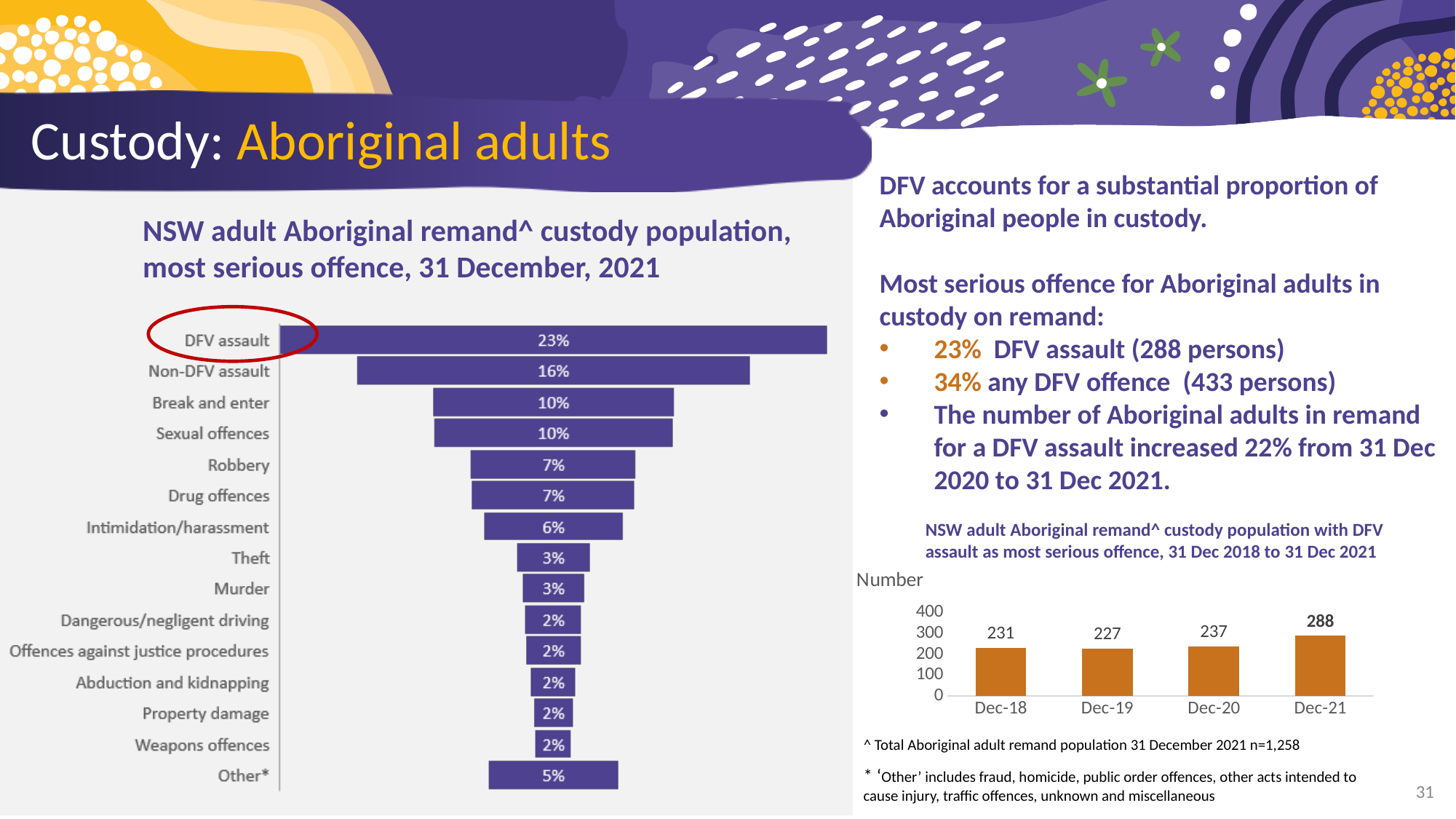
How many bars are shown in the chart titled 'NSW adult Aboriginal remand^ custody population with DFV assault as most serious offence, 31 Dec 2018 to 31 Dec 2021'? 4 What kind of chart is the chart titled 'NSW adult Aboriginal remand^ custody population, most serious offence, 31 December, 2021'? Bar chart In the chart titled 'NSW adult Aboriginal remand^ custody population with DFV assault as most serious offence, 31 Dec 2018 to 31 Dec 2021', what is the difference between Dec-21 and Dec-20? 51 In the chart titled 'NSW adult Aboriginal remand^ custody population, most serious offence, 31 December, 2021', which offence category has the highest value? DFV assault In the chart titled 'NSW adult Aboriginal remand^ custody population with DFV assault as most serious offence, 31 Dec 2018 to 31 Dec 2021', which period has the lowest value? Dec-19 In the chart titled 'NSW adult Aboriginal remand^ custody population, most serious offence, 31 December, 2021', which is larger, Robbery or Theft? Robbery In the chart titled 'NSW adult Aboriginal remand^ custody population, most serious offence, 31 December, 2021', what is the difference between DFV assault and Non-DFV assault? 7 percentage points In the chart titled 'NSW adult Aboriginal remand^ custody population with DFV assault as most serious offence, 31 Dec 2018 to 31 Dec 2021', what is the label on the vertical axis? Number In the chart titled 'NSW adult Aboriginal remand^ custody population, most serious offence, 31 December, 2021', what is the value for DFV assault? 23% How many offence categories are shown in the chart titled 'NSW adult Aboriginal remand^ custody population, most serious offence, 31 December, 2021'? 15 In the chart titled 'NSW adult Aboriginal remand^ custody population with DFV assault as most serious offence, 31 Dec 2018 to 31 Dec 2021', what is the value for Dec-19? 227 In the chart titled 'NSW adult Aboriginal remand^ custody population, most serious offence, 31 December, 2021', what is the value for Intimidation/harassment? 6%